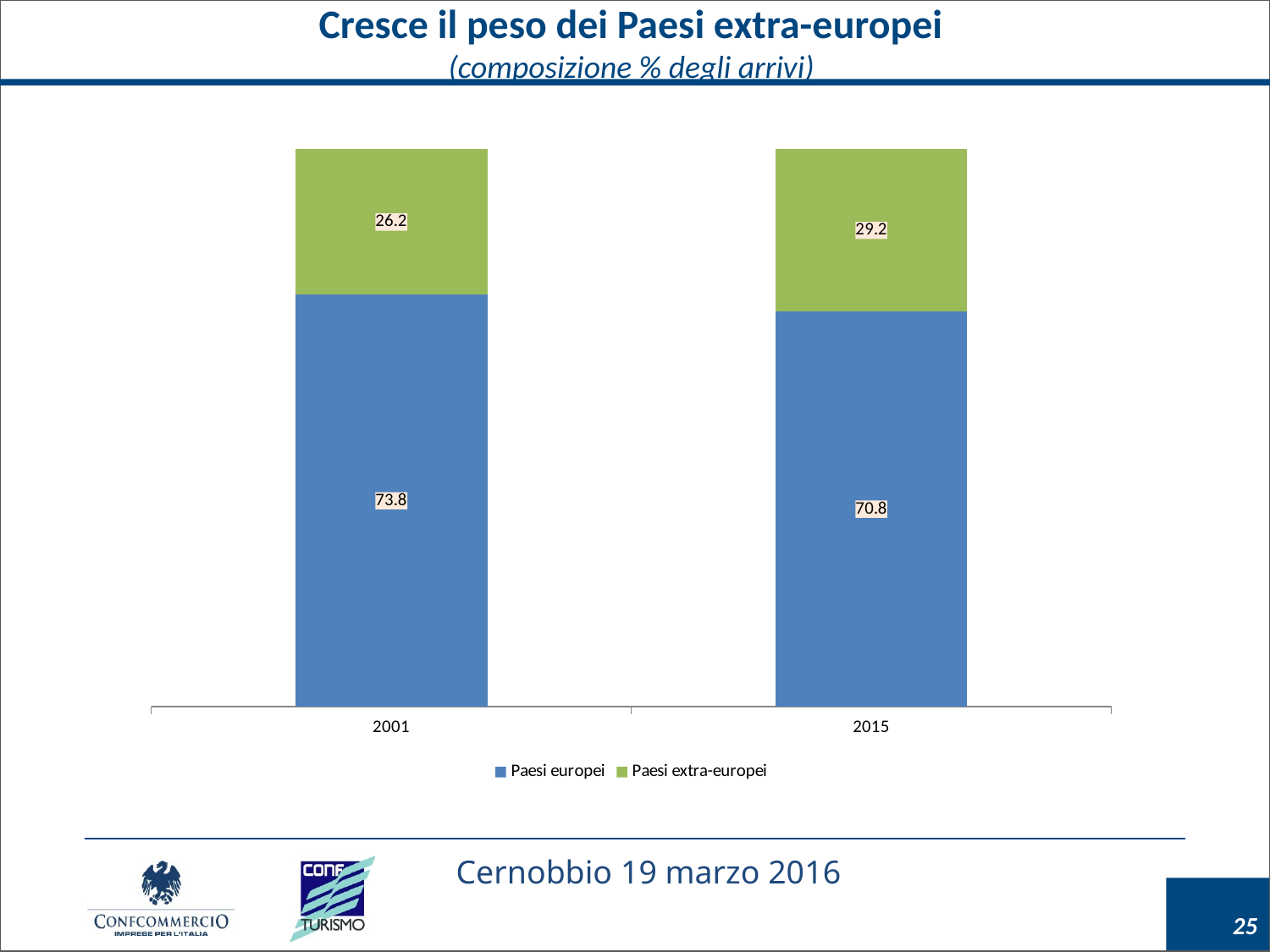
What is the value for Paesi europei in 2015? 70.8 What is the difference between Paesi europei and Paesi extra-europei in 2015? 41.6 What kind of chart is shown on the slide? Stacked bar chart What is the total of the stacked bar for 2001? 100.0 What is the value for Paesi extra-europei in 2015? 29.2 How many categories are shown on the x axis? 2 Which year has the higher value for Paesi extra-europei? 2015 What is the value for Paesi europei in 2001? 73.8 How many series does the legend list? 2 Which is larger in 2001, Paesi europei or Paesi extra-europei? Paesi europei By how much did the Paesi extra-europei share change from 2001 to 2015? 3.0 What is the value for Paesi extra-europei in 2001? 26.2